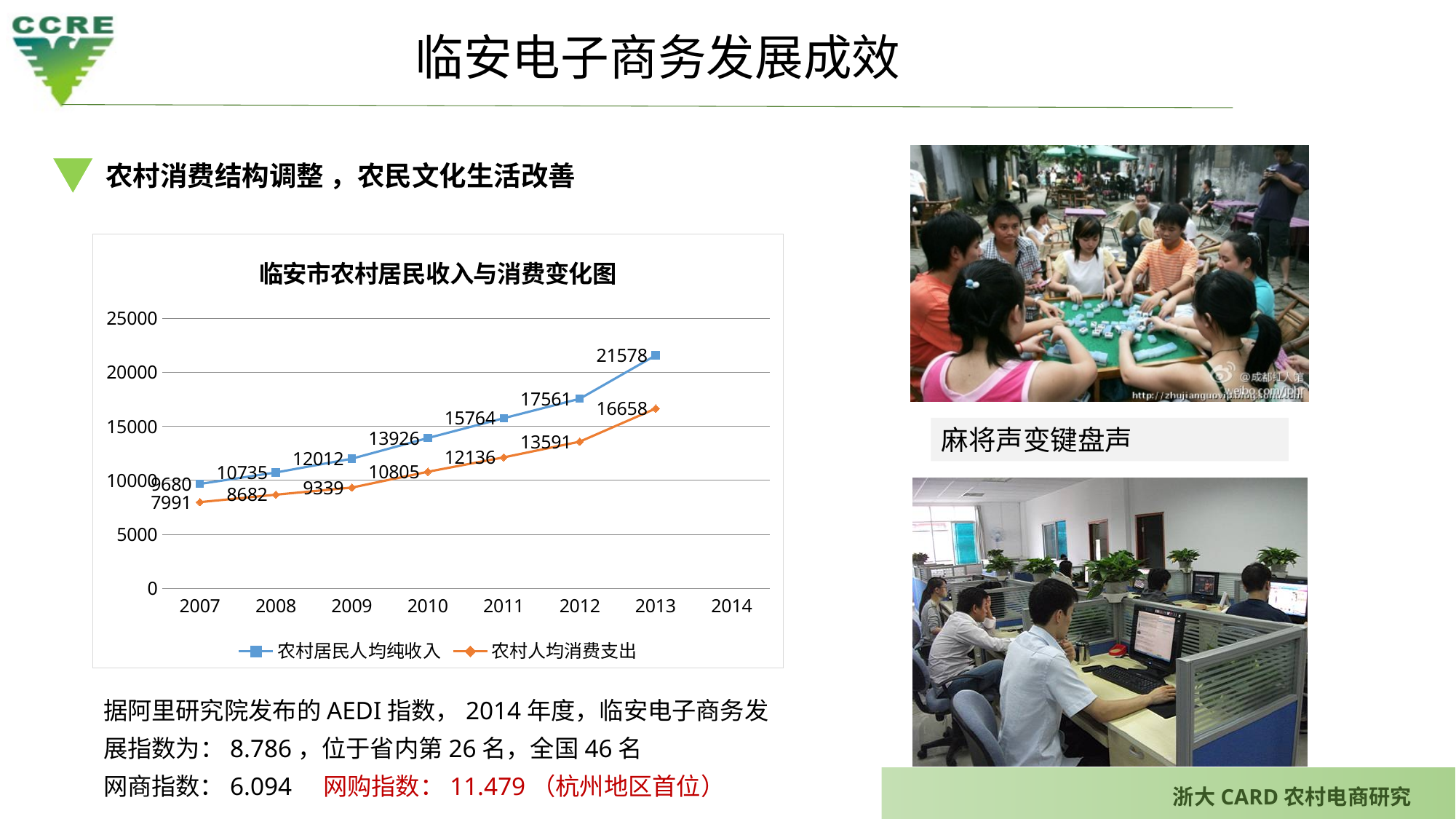
What is the difference between 农村居民人均纯收入 and 农村人均消费支出 in 2013? 4920 What is the value of 农村居民人均纯收入 in 2007? 9680 Does 农村居民人均纯收入 rise or fall from 2007 to 2013? rise What type of chart is shown on the slide? line chart How many series does the legend list? 2 What is the value of 农村人均消费支出 in 2010? 10805 What is the value of 农村人均消费支出 in 2012? 13591 Which is larger in 2011: 农村居民人均纯收入 or 农村人均消费支出? 农村居民人均纯收入 What is the title of the chart? 临安市农村居民收入与消费变化图 In which year is 农村人均消费支出 the highest? 2013 What is the value of 农村居民人均纯收入 in 2013? 21578 In which year is 农村居民人均纯收入 the lowest? 2007